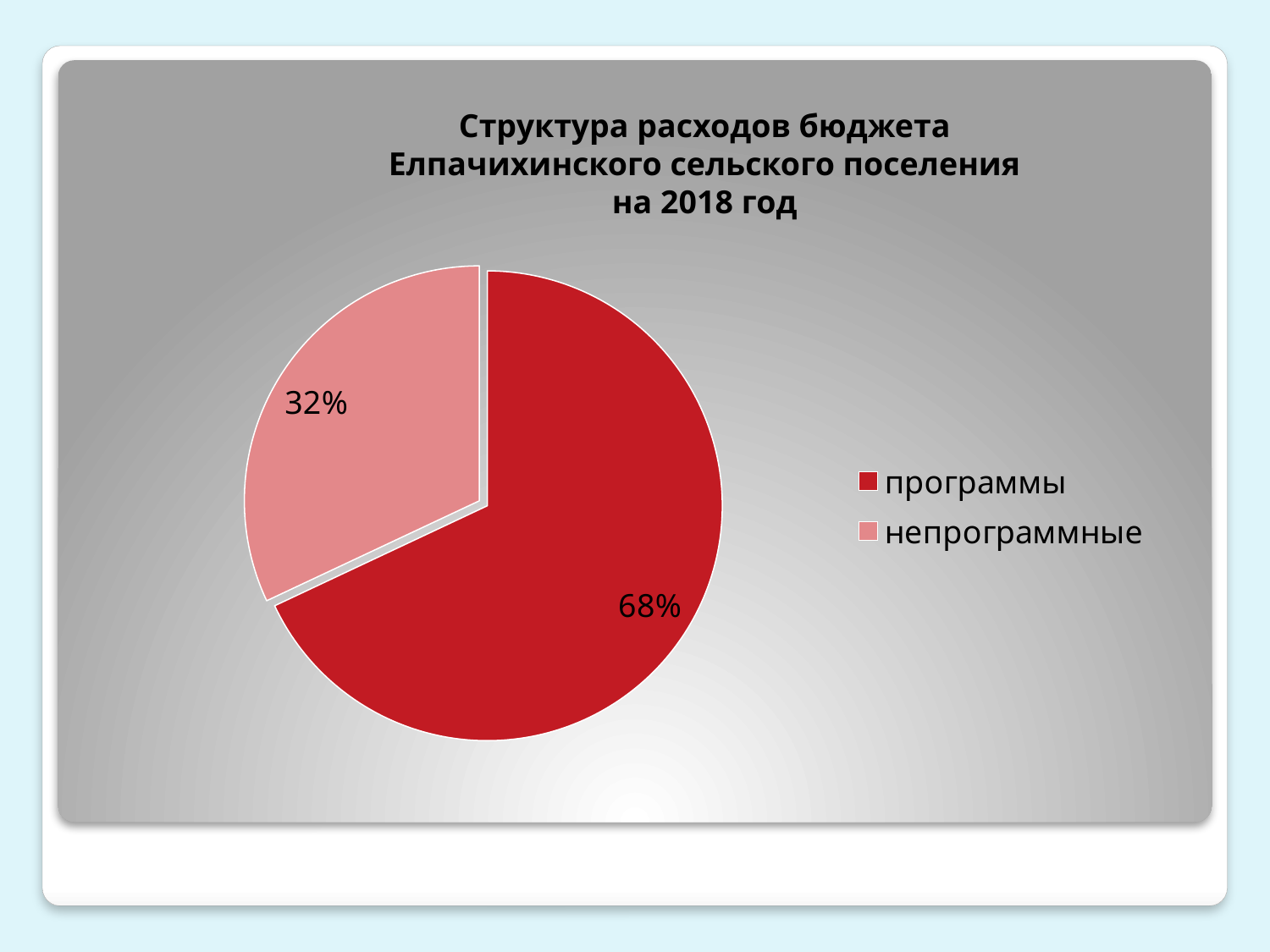
Which category has the largest slice of the pie? программы How many slices does the pie chart have? 2 What share of the pie does the "программы" slice represent? 68% What is the title of the chart? Структура расходов бюджета Елпачихинского сельского поселения на 2018 год What share of the pie does the "непрограммные" slice represent? 32% Which is larger, the "программы" slice or the "непрограммные" slice? программы What colour is the "непрограммные" slice? light pink What is the difference in percentage points between the "программы" and "непрограммные" slices? 36 How many entries does the legend list? 2 Which category has the smallest slice of the pie? непрограммные What kind of chart is shown on the slide? pie chart